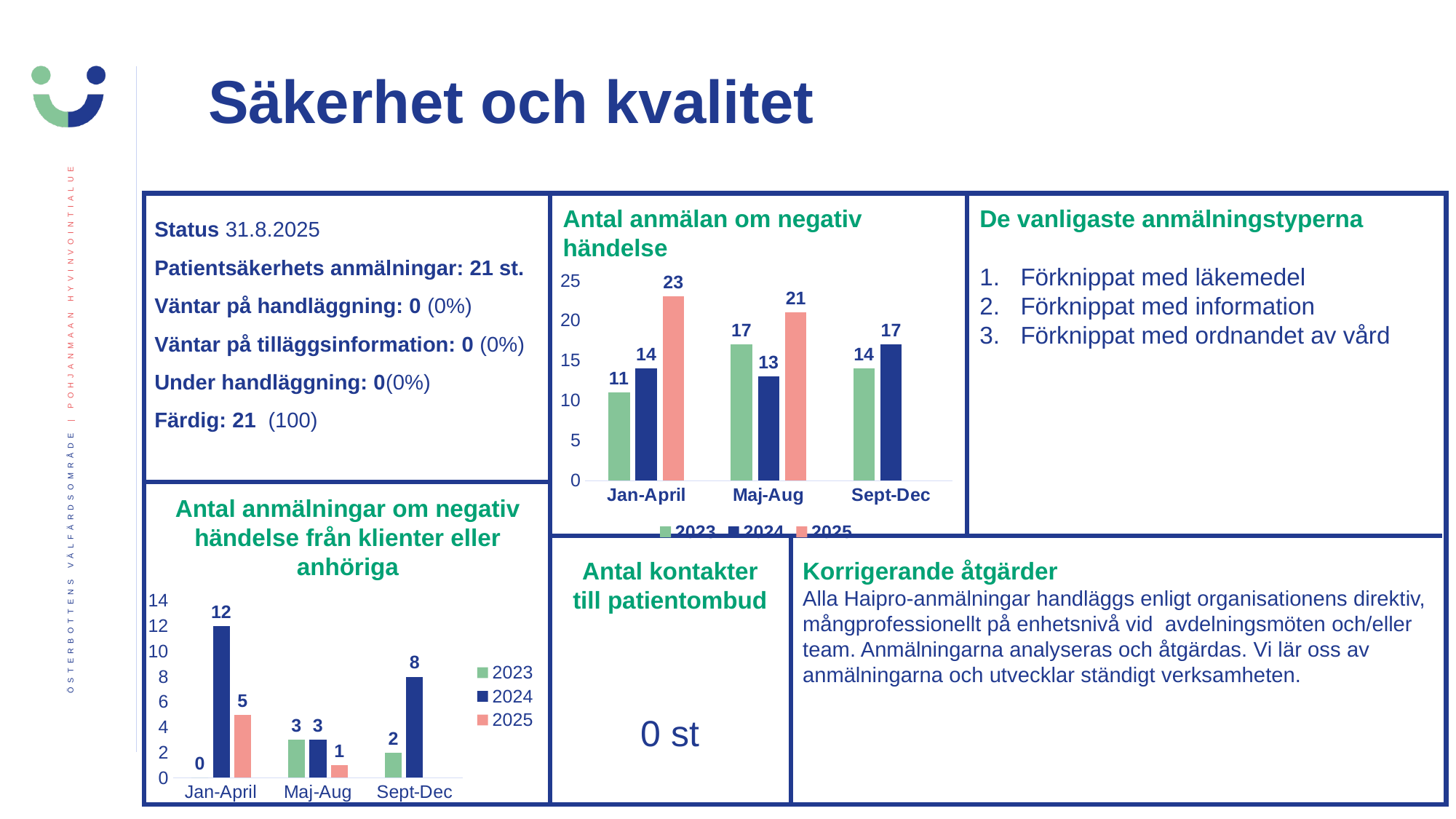
In the chart 'Antal anmälan om negativ händelse', what is the value for 2024 in Maj-Aug? 13 In the chart 'Antal anmälningar om negativ händelse från klienter eller anhöriga', what is the difference between the 2024 values in Jan-April and Sept-Dec? 4 What type of chart is 'Antal anmälningar om negativ händelse från klienter eller anhöriga'? Bar chart In the chart 'Antal anmälan om negativ händelse', what is the value for 2025 in Jan-April? 23 In the chart 'Antal anmälningar om negativ händelse från klienter eller anhöriga', how many periods are shown on the x axis? 3 In the chart 'Antal anmälningar om negativ händelse från klienter eller anhöriga', what is the value for 2024 in Jan-April? 12 In the chart 'Antal anmälningar om negativ händelse från klienter eller anhöriga', what is the value for 2025 in Maj-Aug? 1 In the chart 'Antal anmälan om negativ händelse', how many series does the legend list? 3 In the chart 'Antal anmälan om negativ händelse', which period has the highest value for 2023? Maj-Aug In the chart 'Antal anmälan om negativ händelse', what is the difference between the 2025 and 2023 values in Jan-April? 12 In the chart 'Antal anmälningar om negativ händelse från klienter eller anhöriga', which period has the lowest value for 2023? Jan-April In the chart 'Antal anmälan om negativ händelse', which is larger in Sept-Dec: 2023 or 2024? 2024